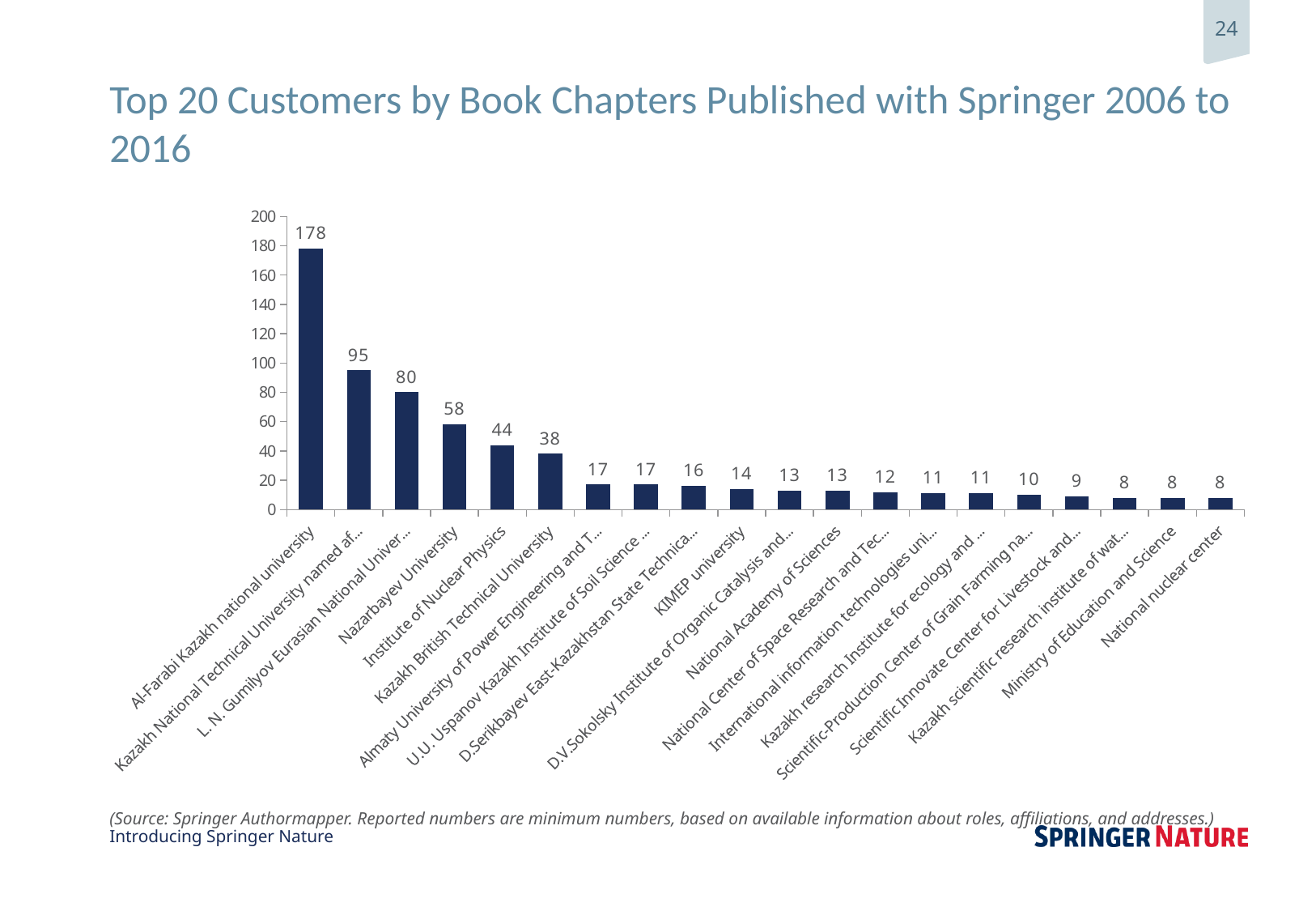
Which has a larger value, Institute of Nuclear Physics or Nazarbayev University? Nazarbayev University What kind of chart is shown on the slide? Bar chart What is the value shown for KIMEP university? 14 What is the difference between the values for Al-Farabi Kazakh national university and Institute of Nuclear Physics? 134 What is the value shown for Nazarbayev University? 58 What is the value shown for National Academy of Sciences? 13 Is the value for Kazakh British Technical University greater or less than 40? less Which customer has the highest number of book chapters published? Al-Farabi Kazakh national university Do the values rise or fall moving from left to right along the x axis? Fall What is the difference between the values for Nazarbayev University and Kazakh British Technical University? 20 How many customers are shown in the chart? 20 How many book chapters did Al-Farabi Kazakh national university publish with Springer according to the chart? 178